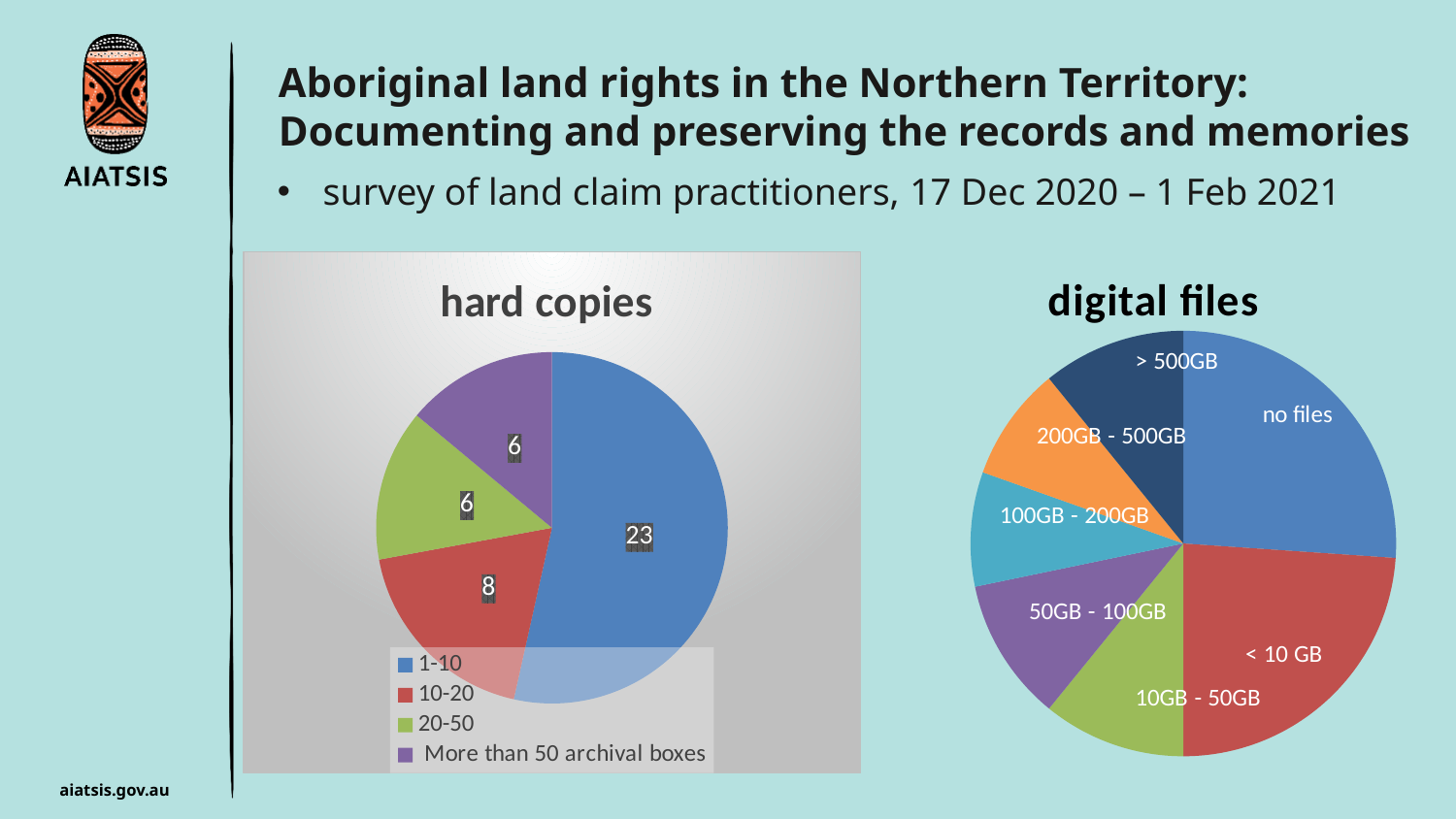
In the "hard copies" chart, which category has the largest slice? 1-10 In the "digital files" chart, which slice is larger, "no files" or "> 500GB"? no files In the "hard copies" chart, which is larger, the 10-20 value or the 20-50 value? 10-20 In the "hard copies" chart, what is the value for the 1-10 category? 23 What kind of chart is the "hard copies" chart? pie chart In the "hard copies" chart, what is the difference between the 1-10 value and the 10-20 value? 15 In the "hard copies" chart, what is the value for the 20-50 category? 6 In the "hard copies" chart, what colour is the "More than 50 archival boxes" slice? purple How many slices does the "digital files" pie chart have? 7 In the "hard copies" chart, what is the total of all the slices? 43 In the "hard copies" chart, what is the value for the 10-20 category? 8 How many categories does the legend of the "hard copies" chart list? 4